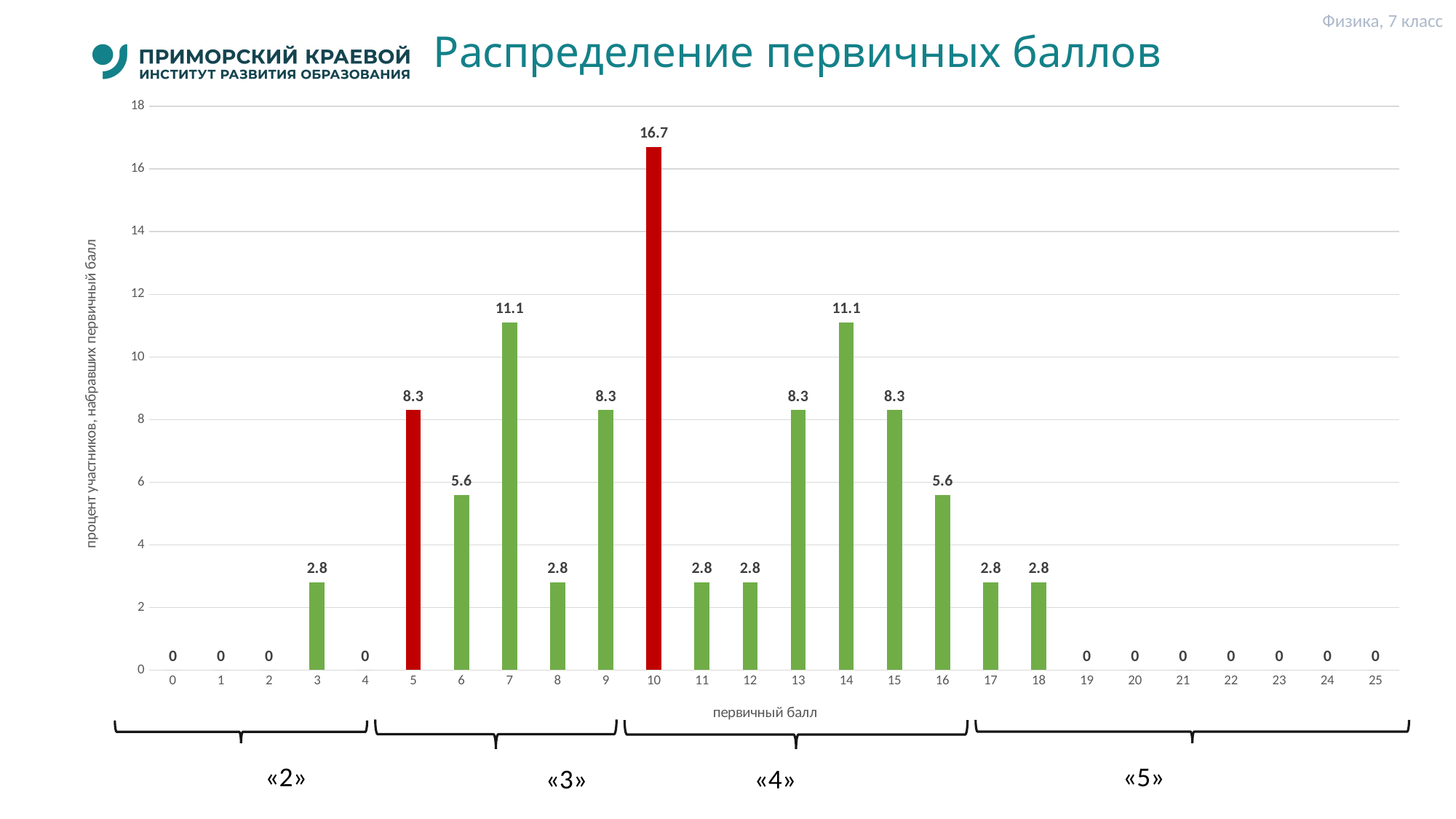
Which primary score has the highest value? 10 Is the value for primary score 10 greater or less than 16? greater What is the difference between the values for primary scores 10 and 14? 5.6 What is the difference between the values for primary scores 5 and 6? 2.7 Which is larger, the value for primary score 9 or the value for primary score 11? 9 What is the value for primary score 7? 11.1 What is the value for primary score 10? 16.7 How many primary score categories are shown on the x axis? 26 What is the value for primary score 3? 2.8 Which two primary scores have red bars? 5 and 10 What kind of chart is shown on the slide? bar chart What is the value for primary score 16? 5.6